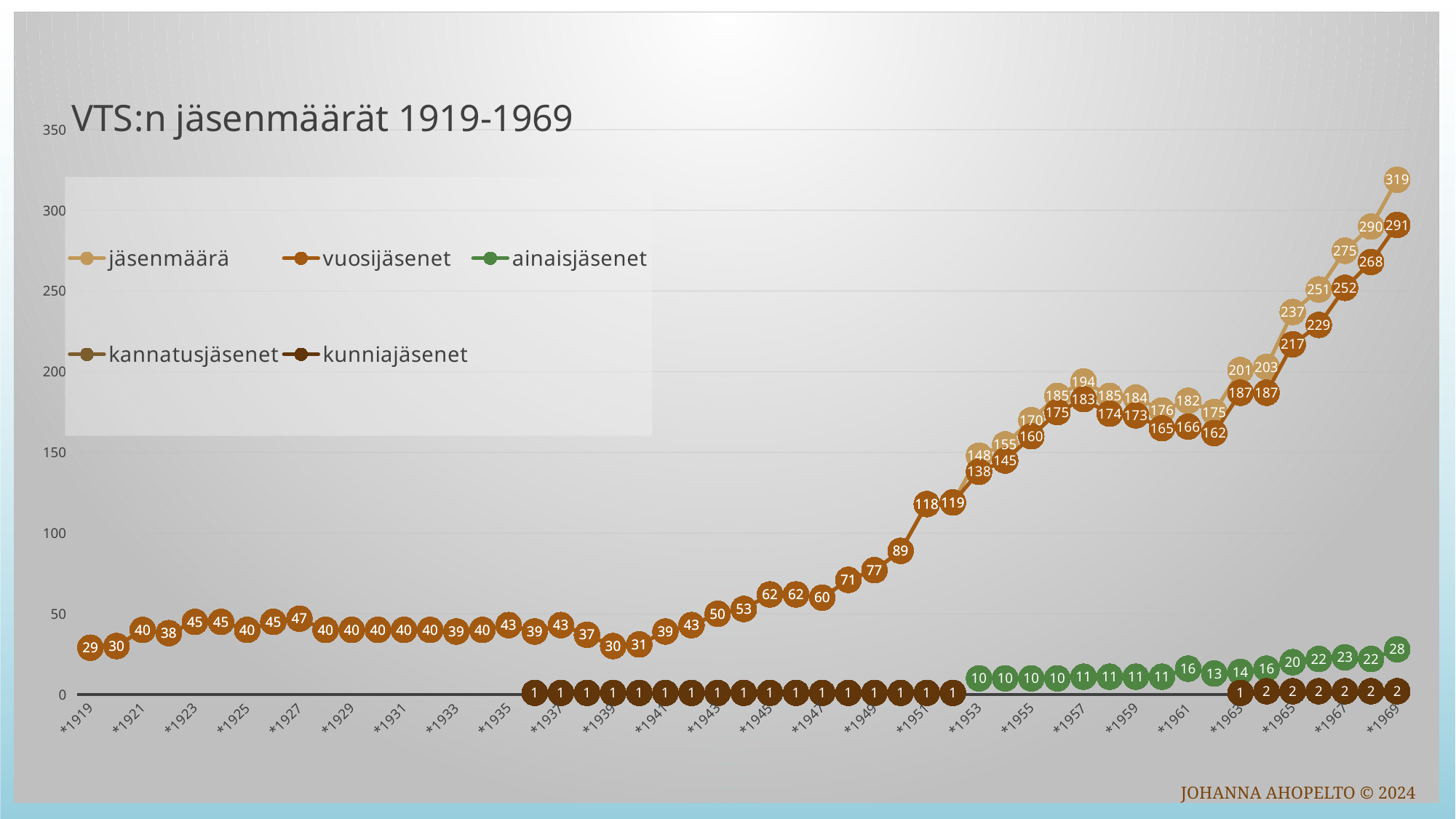
What is the value of ainaisjäsenet in 1969? 28 How many series does the legend list? 5 What is the value of vuosijäsenet in 1919? 29 Which is larger, vuosijäsenet in 1927 or vuosijäsenet in 1919? 1927 What is the difference between jäsenmäärä and vuosijäsenet in 1957? 11 What is the value of jäsenmäärä in 1969? 319 What is the lowest value of the vuosijäsenet series? 29 What is the highest value of the jäsenmäärä series? 319 What kind of chart is shown on the slide? line chart What is the value of kunniajäsenet in 1969? 2 Is the value of vuosijäsenet in 1969 greater or less than 250? greater What is the title of the chart? VTS:n jäsenmäärät 1919-1969